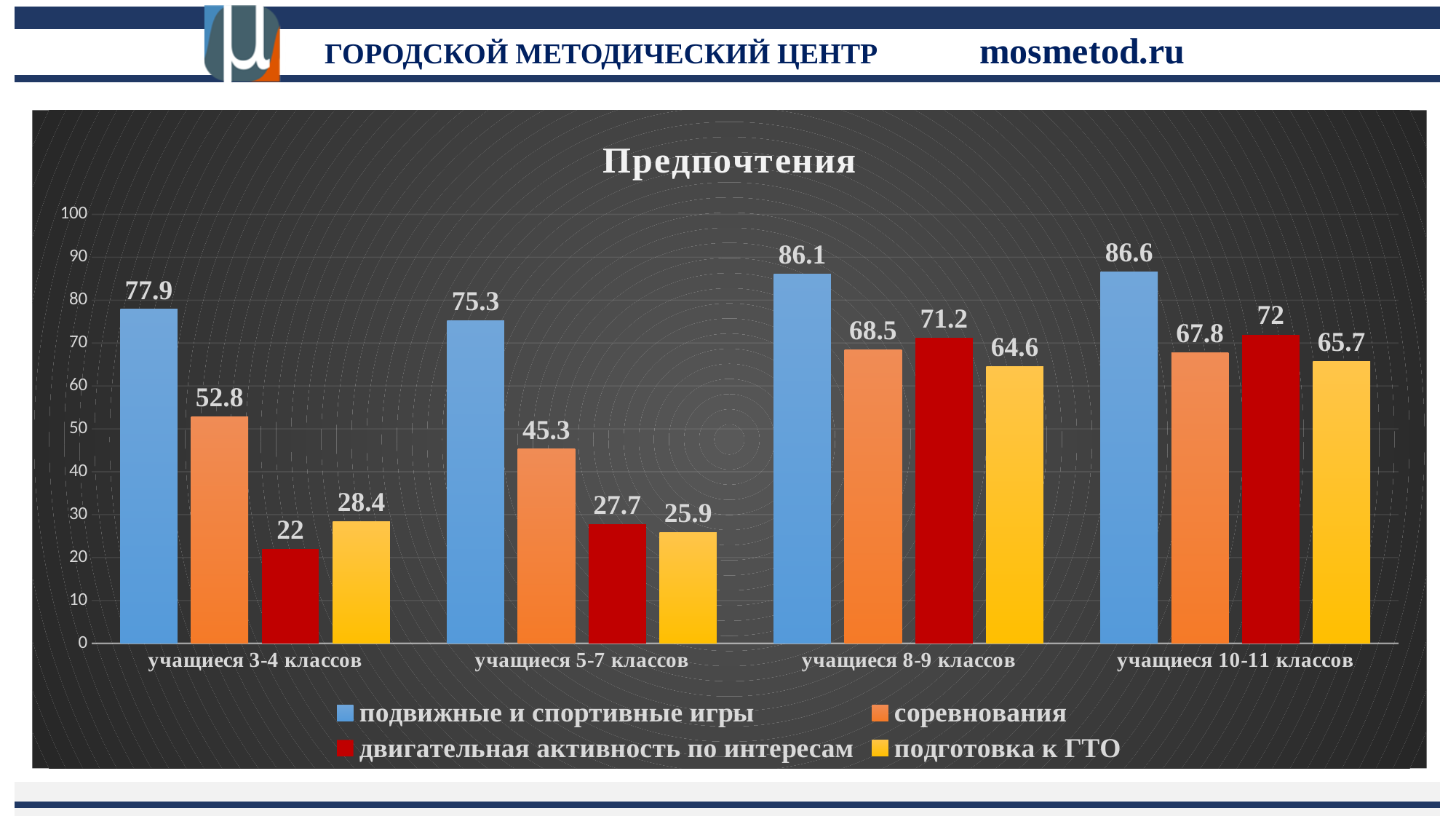
What kind of chart is shown on the slide? bar chart What is the value for «подвижные и спортивные игры» among «учащиеся 8-9 классов»? 86.1 Which group has the lowest value for «двигательная активность по интересам»? учащиеся 3-4 классов Which colour represents «подготовка к ГТО» in the chart? yellow Which is larger for «учащиеся 5-7 классов»: «двигательная активность по интересам» or «подготовка к ГТО»? двигательная активность по интересам How many series does the legend list? 4 What is the title of the chart? Предпочтения What is the value for «подготовка к ГТО» among «учащиеся 3-4 классов»? 28.4 What is the value for «двигательная активность по интересам» among «учащиеся 10-11 классов»? 72 How many student groups are shown on the x axis? 4 What is the difference between «соревнования» for «учащиеся 8-9 классов» and for «учащиеся 5-7 классов»? 23.2 Which group has the highest value for «подвижные и спортивные игры»? учащиеся 10-11 классов